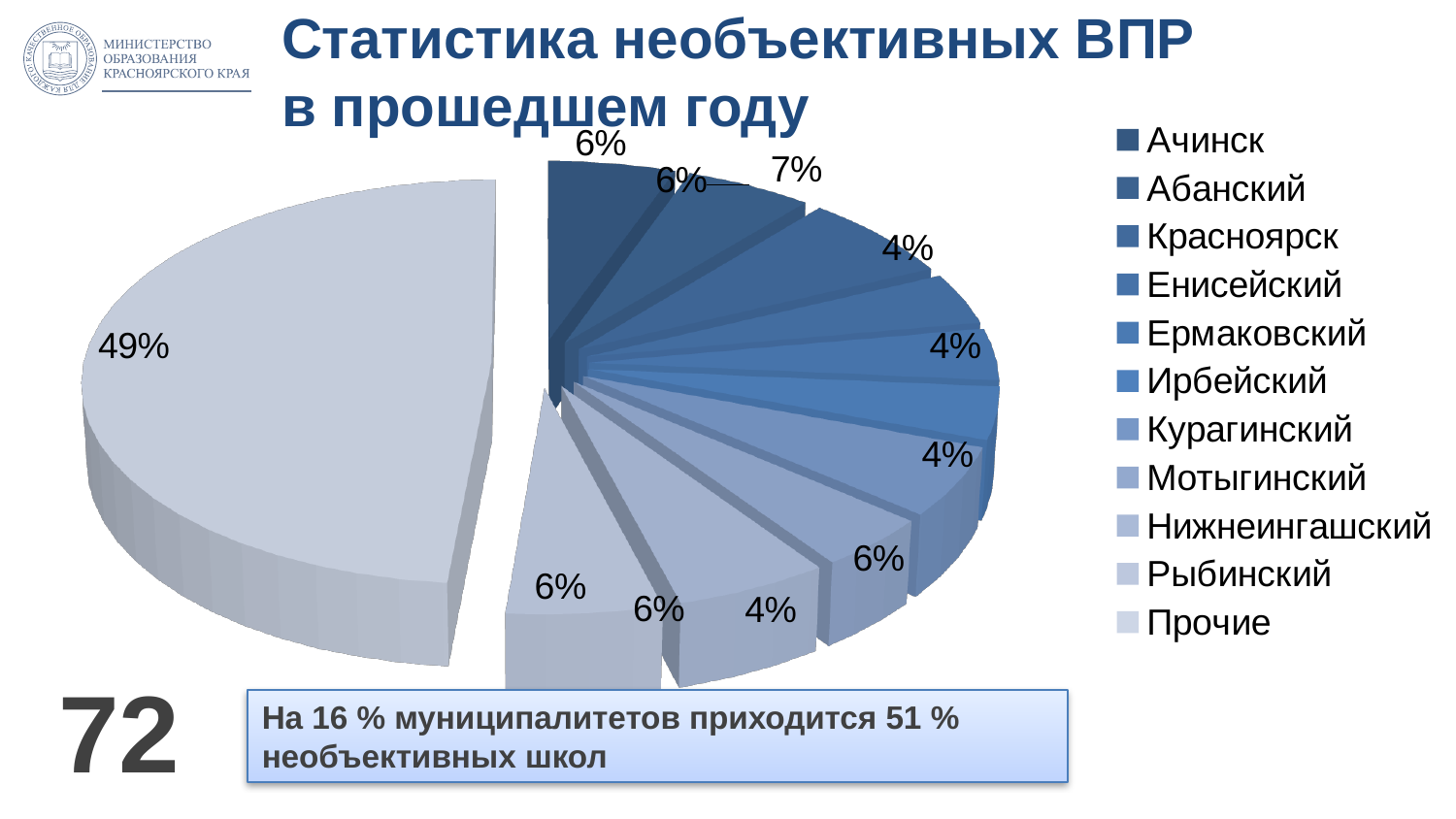
What is the difference between the 'Прочие' slice (49%) and the 'Красноярск' slice (7%)? 42% What kind of chart is shown on the slide? pie chart Is the share of 'Прочие' greater or less than 40%? greater Which legend entry is listed last in the pie chart's legend? Прочие How many categories does the legend of the pie chart list? 11 What is the largest percentage label shown on the pie chart? 49% Which category has the largest slice in the pie chart? Прочие What share of the pie does the 'Прочие' slice take? 49% What is the smallest percentage label shown on the pie chart? 4% Which is larger: the slice for 'Прочие' or the slice for 'Красноярск'? Прочие What share of the pie does the 'Красноярск' slice take? 7% What is the title of the chart on the slide? Статистика необъективных ВПР в прошедшем году